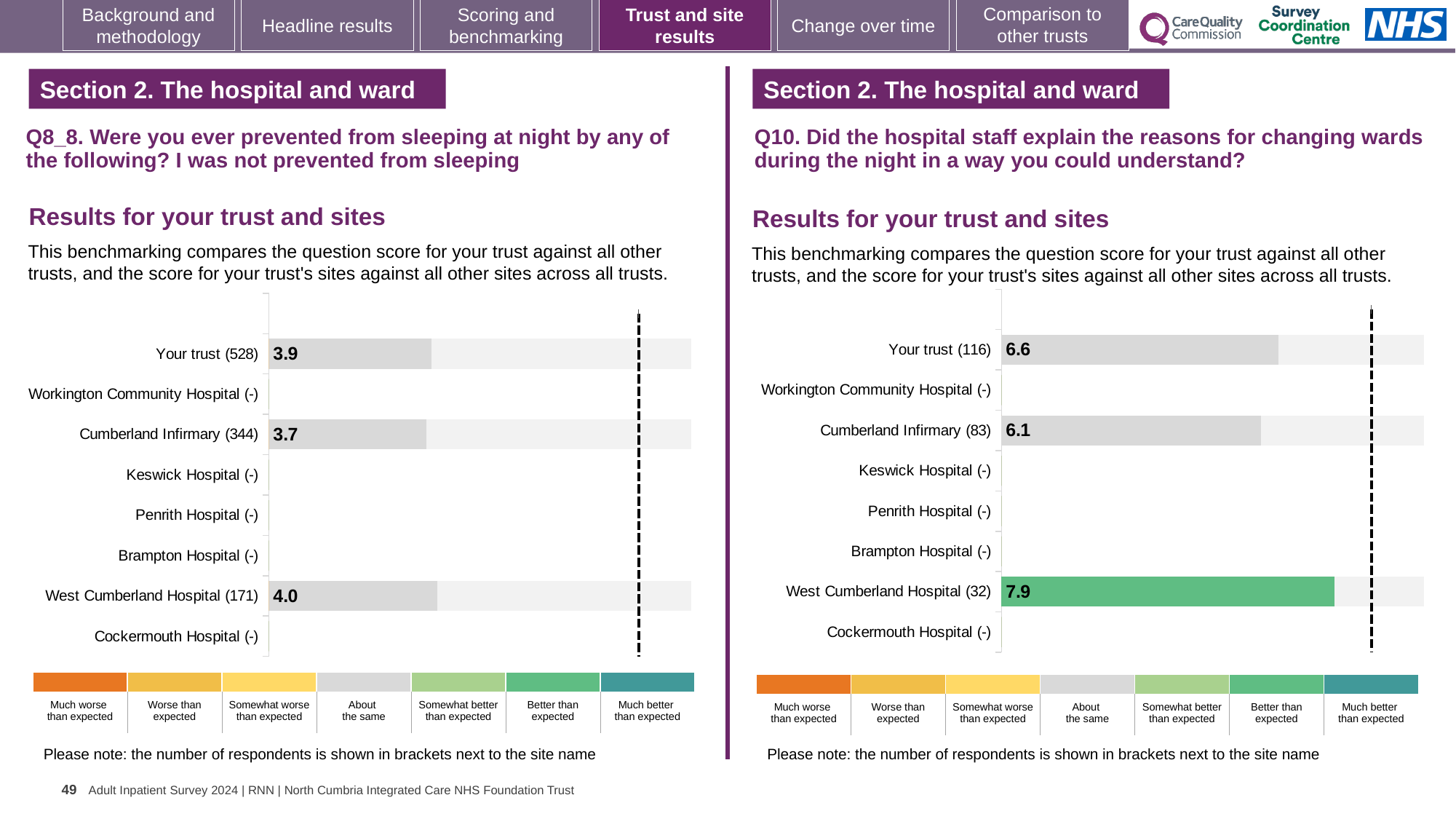
In the Q8_8 chart on the left, what is the difference between the scores for West Cumberland Hospital and Cumberland Infirmary? 0.3 In the Q8_8 chart on the left, which site with a plotted bar has the highest score? West Cumberland Hospital (171) In the Q10 chart on the right, which has the higher score: Your trust or Cumberland Infirmary? Your trust What kind of chart is used in the Q10 chart on the right? Bar chart How many site/trust rows are listed on the y axis of the Q8_8 chart on the left? 8 In the Q10 chart on the right, which benchmark category does the green colour of the West Cumberland Hospital bar represent? Better than expected In the Q8_8 chart on the left, what is the score for Your trust (528)? 3.9 In the Q10 chart on the right, which site with a plotted bar has the lowest score? Cumberland Infirmary (83) In the Q10 chart on the right, what is the difference between the scores for West Cumberland Hospital and Your trust? 1.3 In the Q10 chart on the right, what is the score for Your trust (116)? 6.6 In the Q8_8 chart on the left, what is the score for Cumberland Infirmary (344)? 3.7 In the Q10 chart on the right, what is the score for West Cumberland Hospital (32)? 7.9